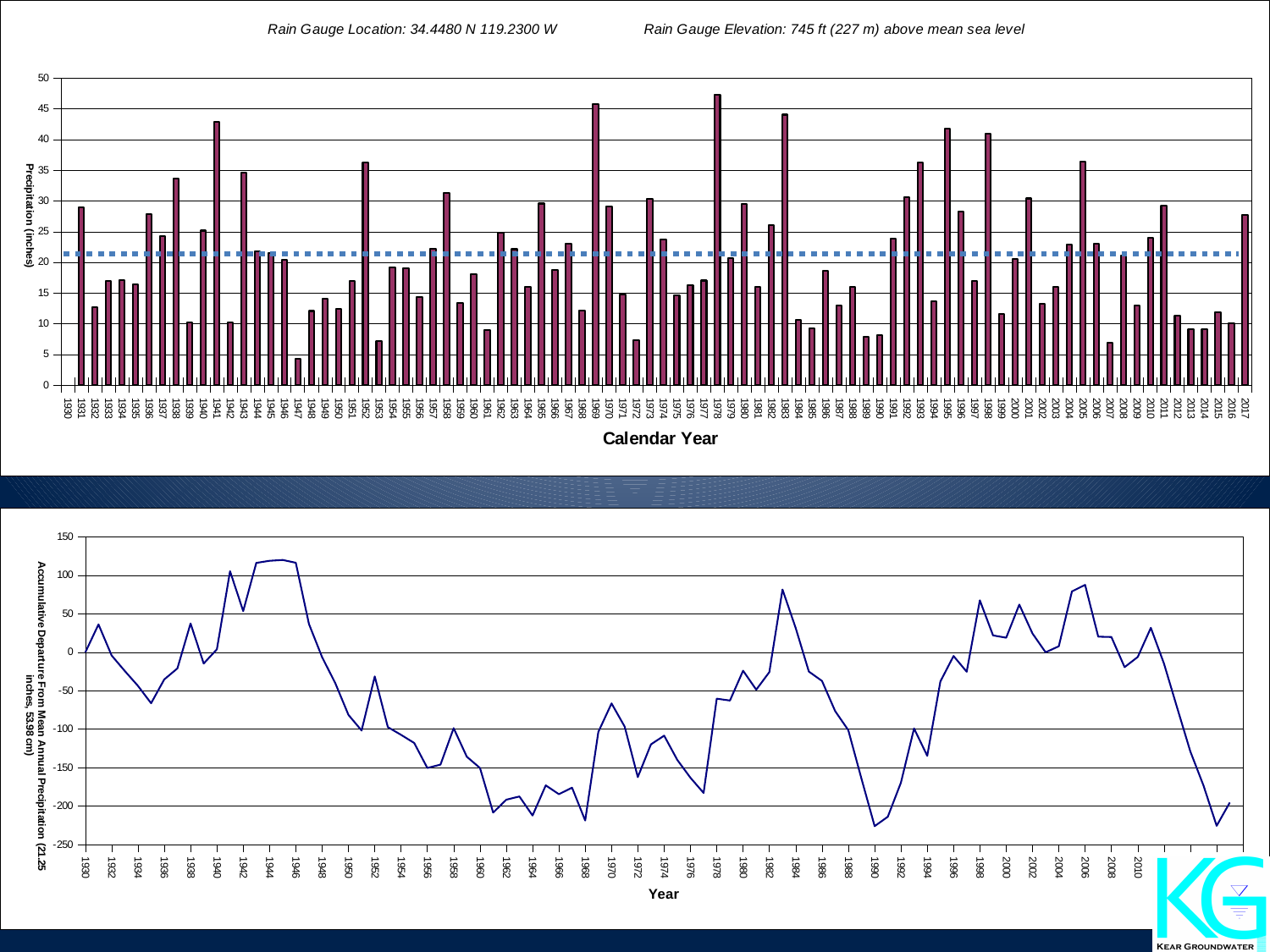
In the top precipitation bar chart, which calendar year has the highest precipitation? 1978 In the top precipitation bar chart, what is the title of the x axis? Calendar Year In the top precipitation bar chart, which year has the larger value, 1969 or 1970? 1969 In the bottom accumulative departure line chart, is the value for 1945 greater or less than 100? greater In the top precipitation bar chart, is the value for 1941 greater or less than 40? greater In the top precipitation bar chart, is the value for 1972 greater or less than 10? less What kind of chart is the bottom chart (Accumulative Departure From Mean Annual Precipitation)? line chart What kind of chart is the top chart (Precipitation by Calendar Year)? bar chart In the bottom accumulative departure line chart, does the line rise or fall between 1946 and 1950? fall In the top precipitation bar chart, which calendar year has the lowest precipitation? 1947